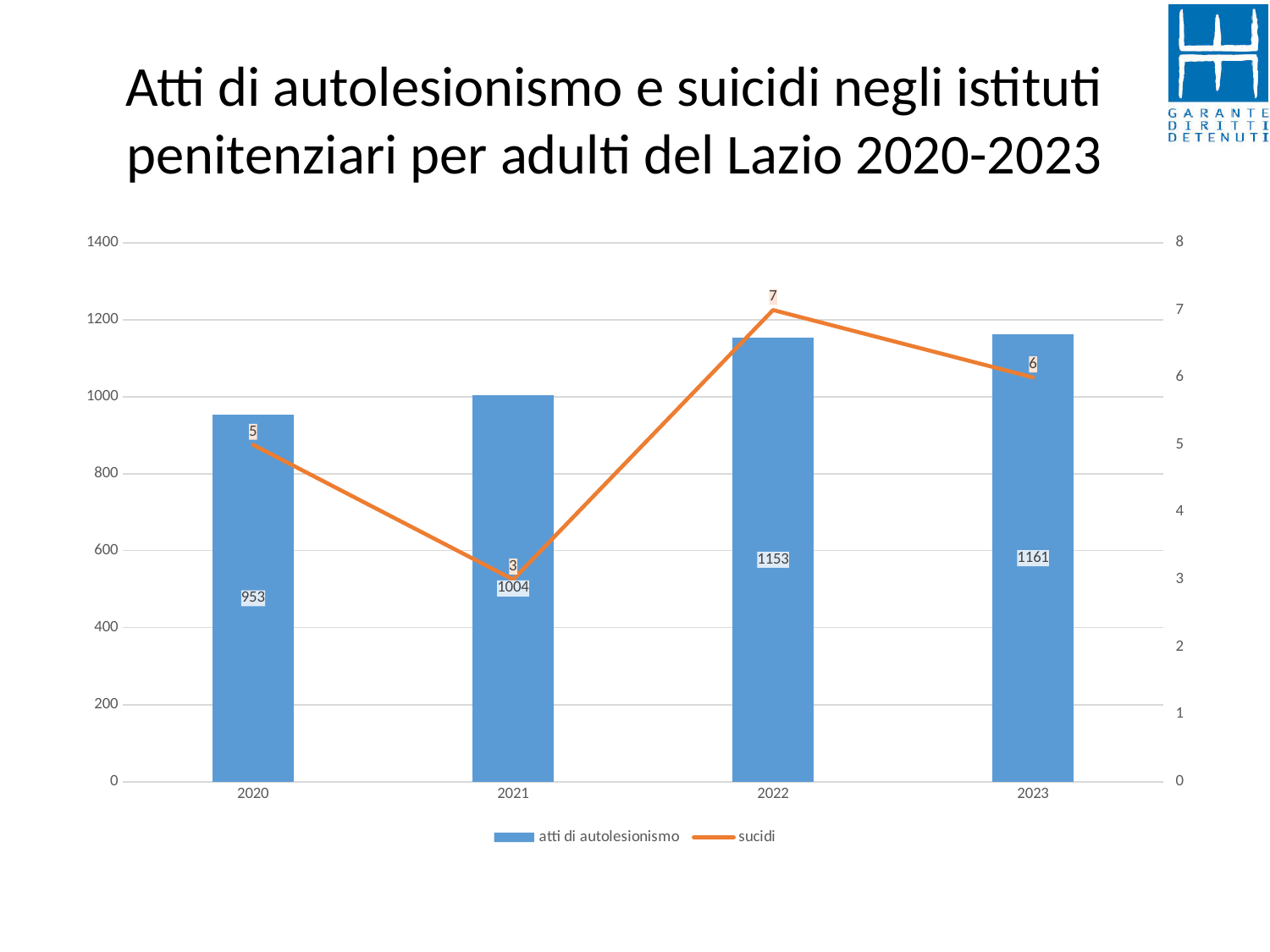
Do the values for atti di autolesionismo rise or fall from 2020 to 2023? rise Which year has the highest value for atti di autolesionismo? 2023 How many years are shown on the x axis? 4 How many series does the legend list? 2 Which year has more sucidi, 2020 or 2022? 2022 What is the value of atti di autolesionismo for 2020? 953 What is the value of atti di autolesionismo for 2022? 1153 Which year has the lowest value for sucidi? 2021 How many sucidi are shown for 2023? 6 Which series is drawn as a line? sucidi How many sucidi are shown for 2021? 3 What is the difference in atti di autolesionismo between 2022 and 2021? 149